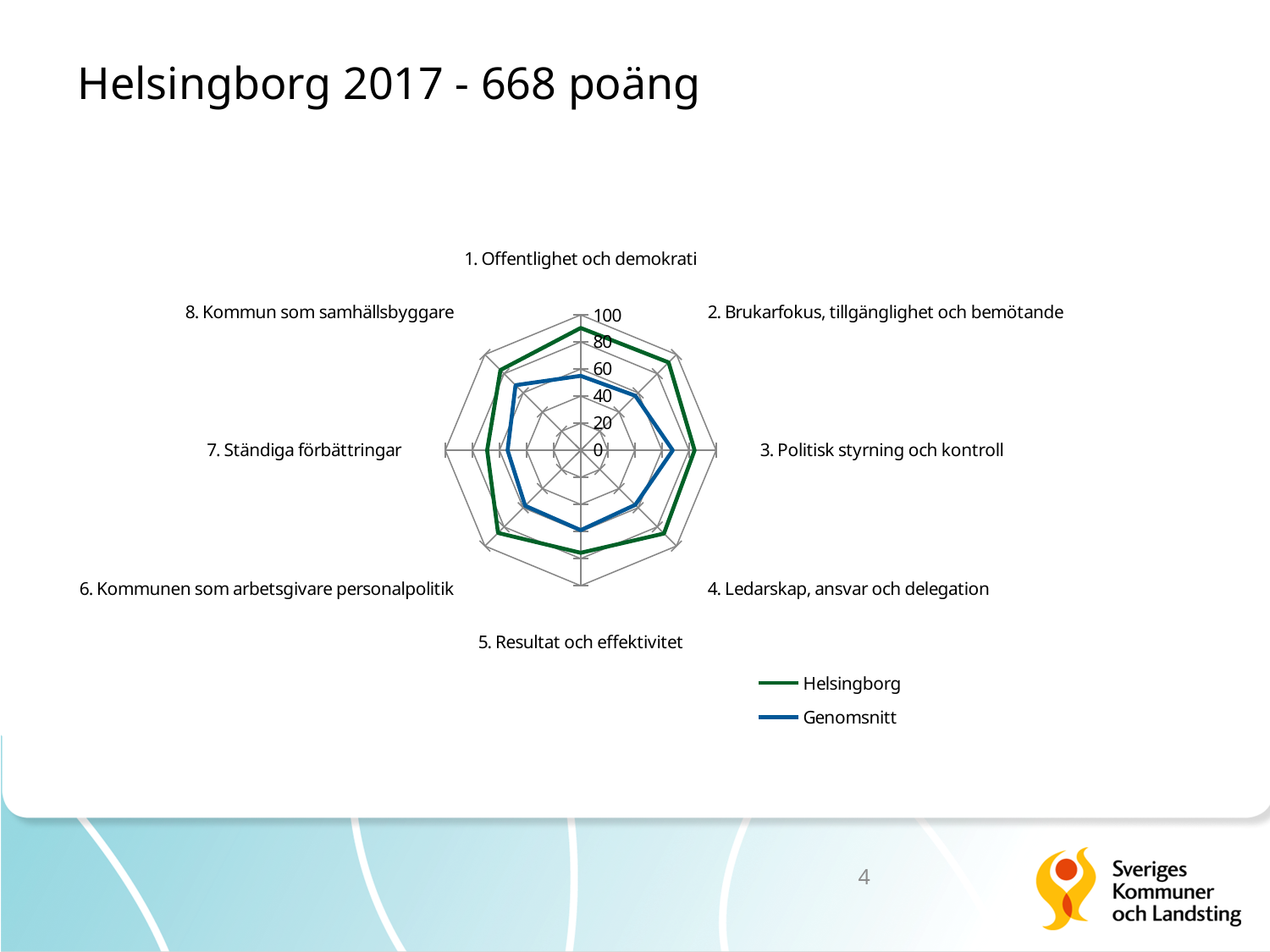
What are the two series named in the legend? Helsingborg and Genomsnitt On which category does the Genomsnitt series have its highest value? 3. Politisk styrning och kontroll and 8. Kommun som samhällsbyggare (tied) What is the title of the slide containing the chart? Helsingborg 2017 - 668 poäng Is the Helsingborg value for '1. Offentlighet och demokrati' greater or less than 80? greater What kind of chart is shown on the slide? Radar chart For '1. Offentlighet och demokrati', which series has the higher value, Helsingborg or Genomsnitt? Helsingborg How many categories (axes) does the radar chart have? 8 On which category does the Helsingborg series have its lowest value? 7. Ständiga förbättringar Is the Helsingborg value for '7. Ständiga förbättringar' greater or less than 80? less How many series does the legend list? 2 Is the Genomsnitt value for '3. Politisk styrning och kontroll' greater or less than 80? less